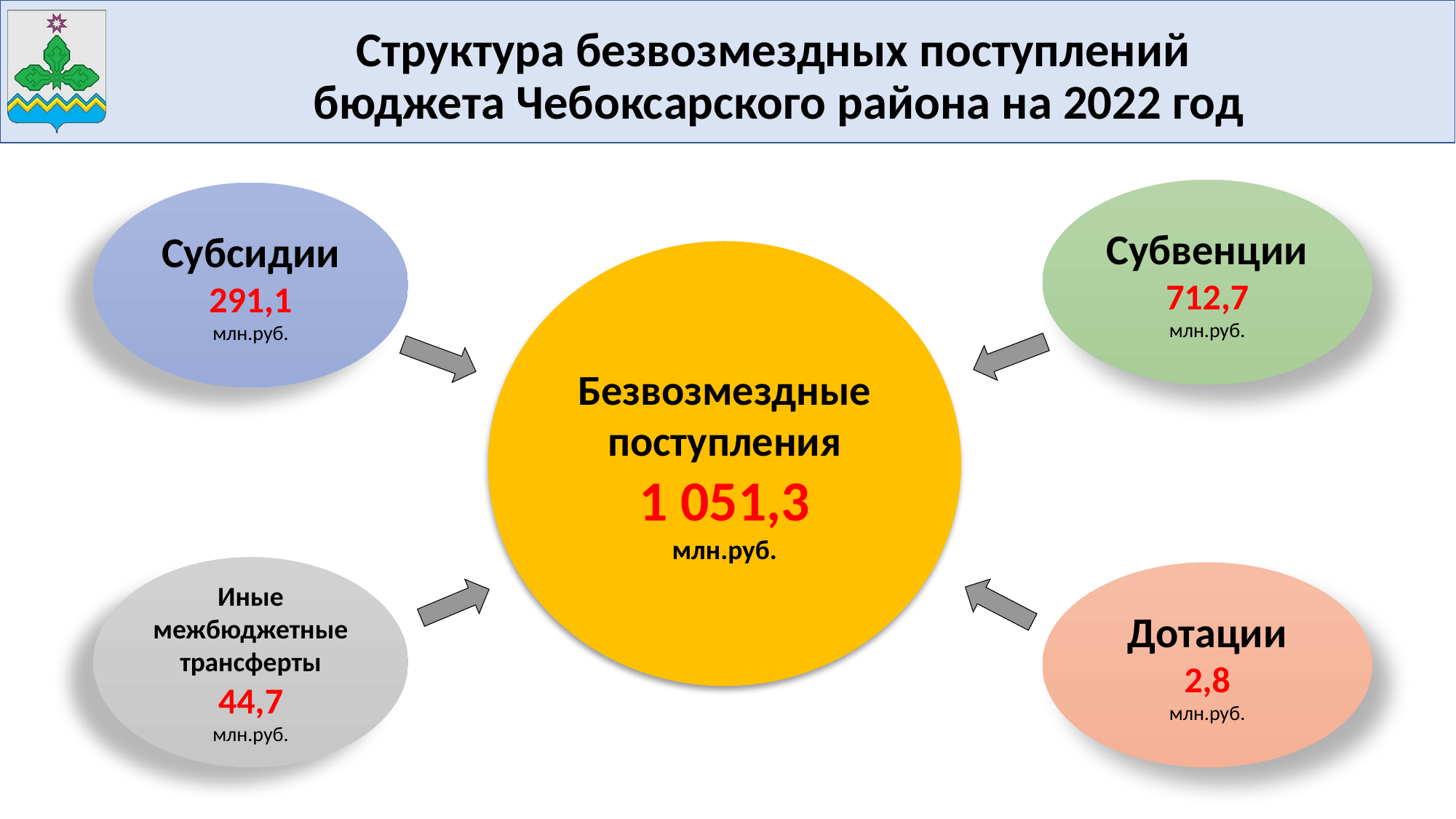
What is the total value of Безвозмездные поступления shown in the central circle? 1 051,3 млн.руб. What is the value for Иные межбюджетные трансферты? 44,7 млн.руб. What is the title of the slide? Структура безвозмездных поступлений бюджета Чебоксарского района на 2022 год Which is larger, Иные межбюджетные трансферты or Дотации? Иные межбюджетные трансферты Which component of the безвозмездные поступления has the highest value? Субвенции What is the value for Дотации? 2,8 млн.руб. What is the difference between Субвенции and Субсидии? 421,6 млн.руб. Which component of the безвозмездные поступления has the lowest value? Дотации How many components of безвозмездные поступления are shown around the central circle? 4 What is the value for Субсидии? 291,1 млн.руб. What is the difference between Субсидии and Иные межбюджетные трансферты? 246,4 млн.руб. What is the value for Субвенции on the slide? 712,7 млн.руб.